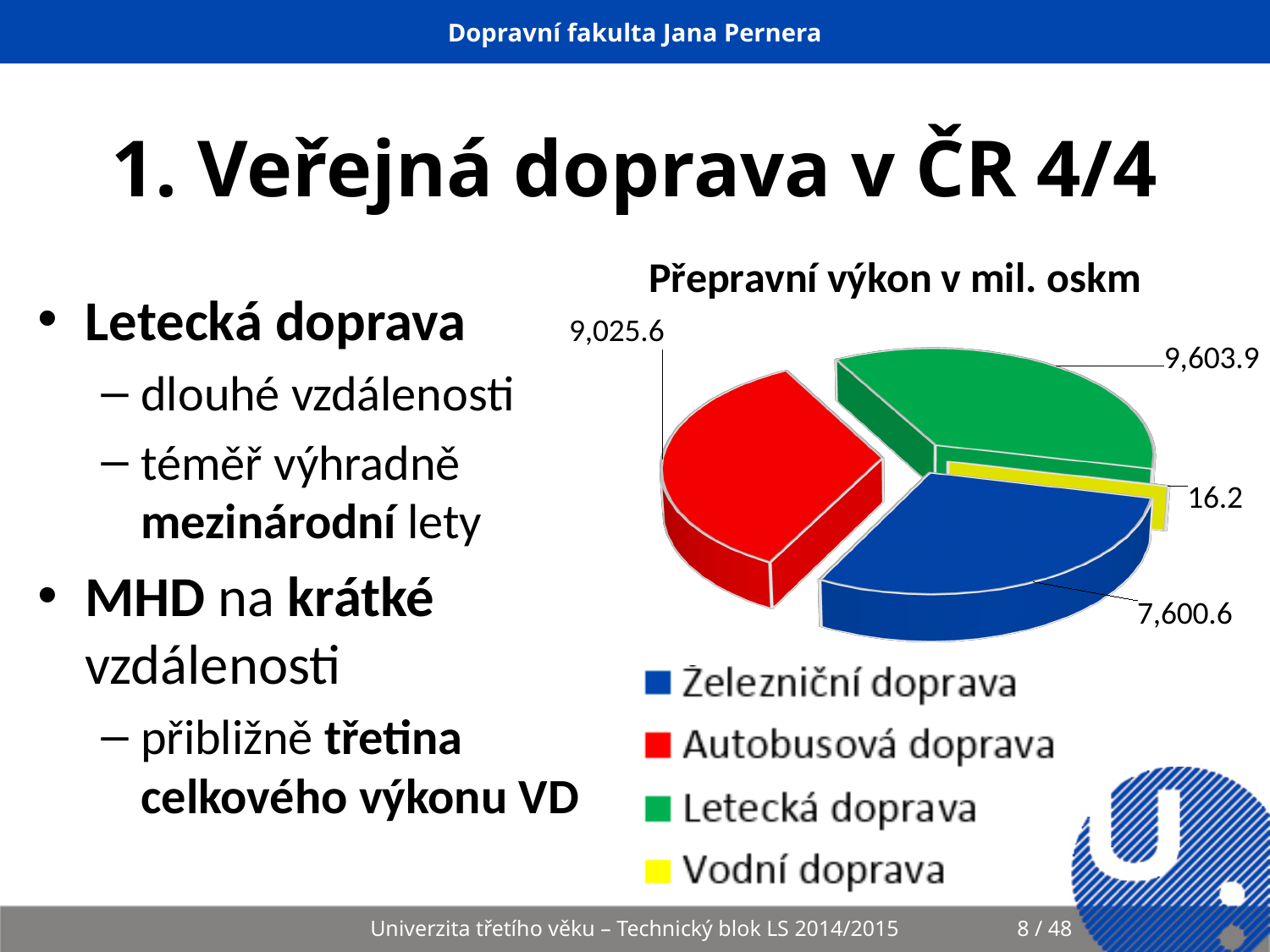
What is the value for Vodní doprava? 16.2 What is the difference between the values for Letecká doprava and Autobusová doprava? 578.3 What is the value for Železniční doprava? 7,600.6 What type of chart is shown on the slide? pie chart Which category has the lowest value? Vodní doprava What colour represents Vodní doprava in the legend? yellow What is the value for Autobusová doprava? 9,025.6 Which category has the highest value? Letecká doprava What is the value for Letecká doprava? 9,603.9 Which is larger, the value for Autobusová doprava or Železniční doprava? Autobusová doprava What is the title of the chart? Přepravní výkon v mil. oskm How many slices does the pie chart have? 4